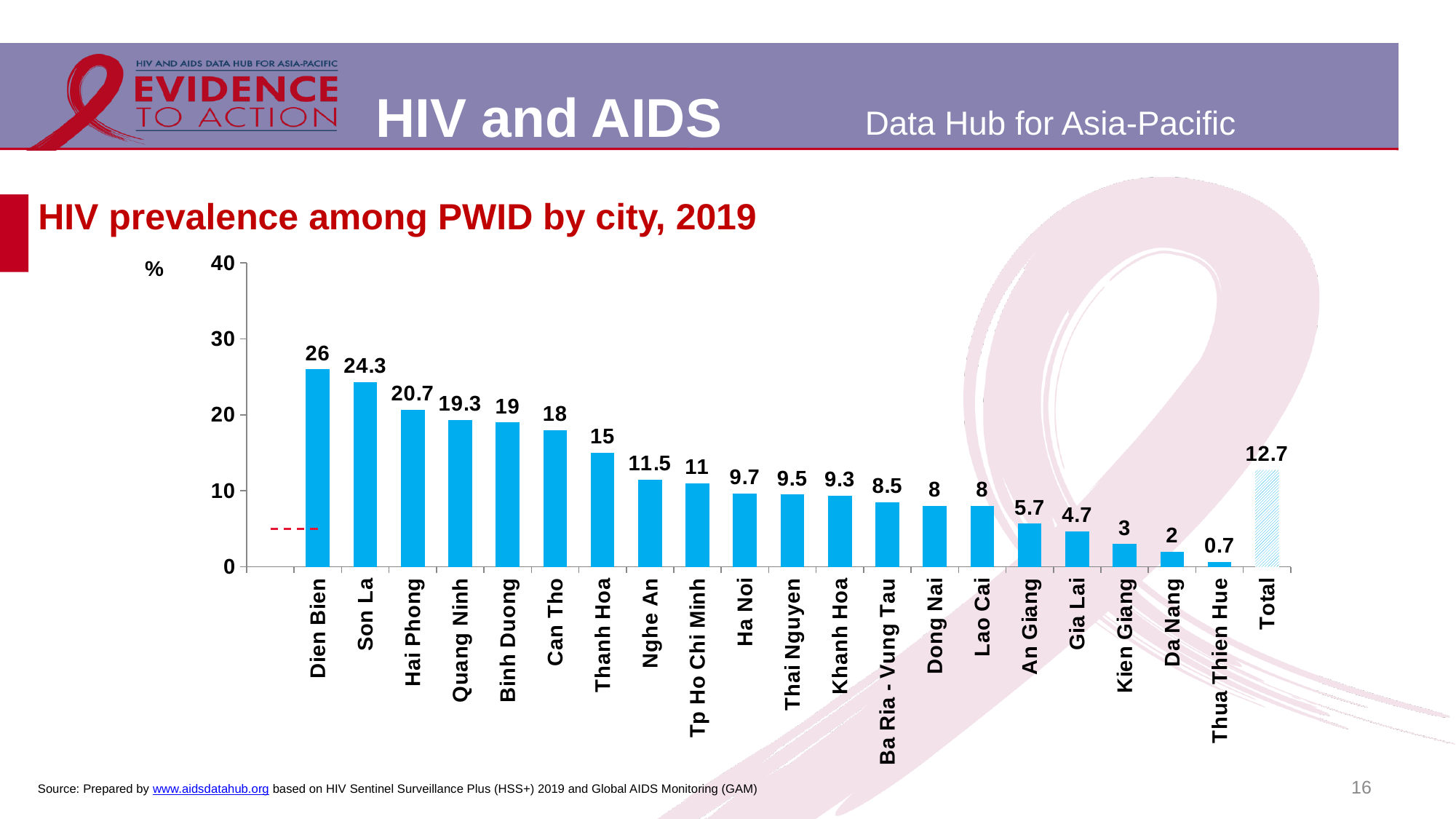
How many cities (excluding the Total bar) are shown on the chart? 20 Do the city values rise or fall from left to right along the x axis? Fall Which city has the highest HIV prevalence among PWID? Dien Bien Is the value for Can Tho greater or less than 20? less What kind of chart is shown on the slide? Bar chart What is the title of the chart? HIV prevalence among PWID by city, 2019 What is the HIV prevalence among PWID in Dien Bien? 26 Which city has the lowest HIV prevalence among PWID? Thua Thien Hue What is the value shown for Tp Ho Chi Minh? 11 What is the value shown for the Total bar? 12.7 Which has a higher value, Ha Noi or Thanh Hoa? Thanh Hoa What is the difference between the values for Son La and Hai Phong? 3.6